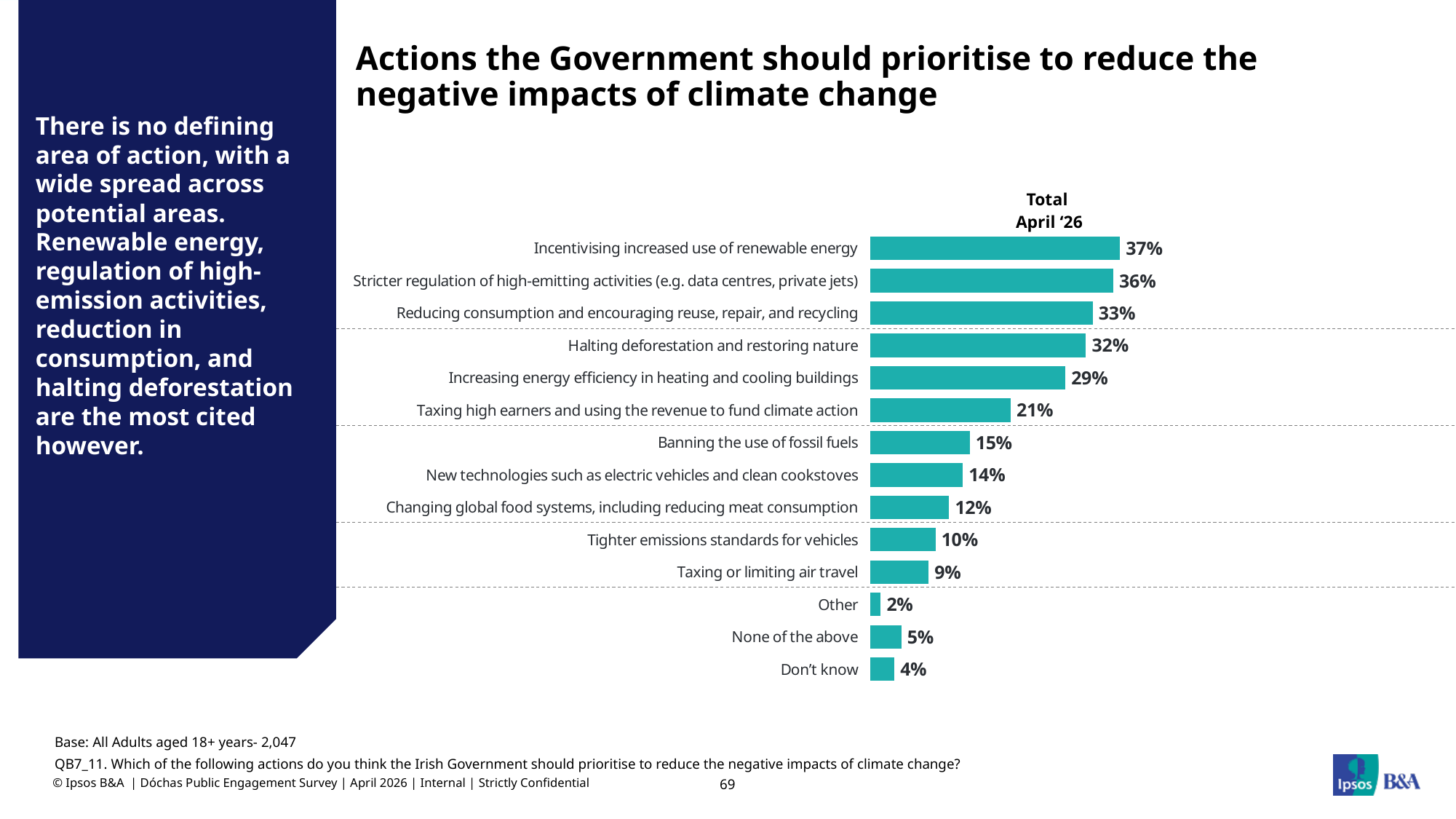
What percentage of respondents chose 'Incentivising increased use of renewable energy'? 37% What is the column header above the bars? Total April '26 What is the value for 'Don't know'? 4% How many categories are shown in the chart? 14 What is the value for 'Halting deforestation and restoring nature'? 32% Which is larger: 'Taxing high earners and using the revenue to fund climate action' or 'New technologies such as electric vehicles and clean cookstoves'? Taxing high earners and using the revenue to fund climate action What kind of chart is shown on the slide? Bar chart What is the base size stated on the slide? 2,047 What is the difference between 'Stricter regulation of high-emitting activities' and 'Banning the use of fossil fuels'? 21 percentage points What percentage selected 'Taxing or limiting air travel'? 9% Which category has the lowest percentage? Other Which action has the highest percentage? Incentivising increased use of renewable energy